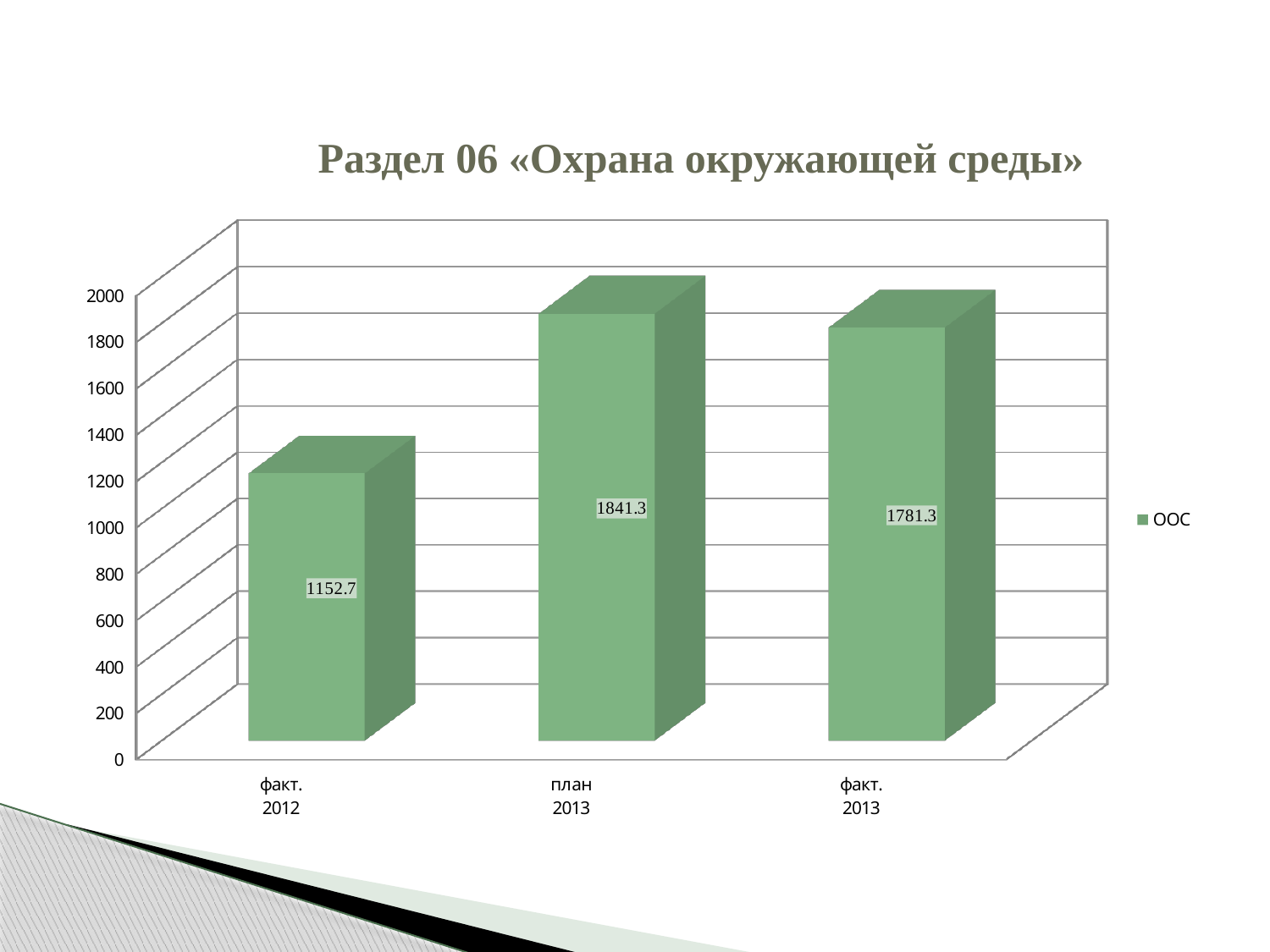
What is the difference between план 2013 and факт. 2013? 60 What is the value for факт. 2013? 1781.3 How many categories are shown on the chart? 3 What is the value for план 2013? 1841.3 What is the title of the chart? Раздел 06 «Охрана окружающей среды» What is the difference between факт. 2013 and факт. 2012? 628.6 Which category has the lowest value? факт. 2012 What kind of chart is shown on the slide? bar chart How many series does the legend list? 1 What is the value for факт. 2012? 1152.7 Which category has the highest value? план 2013 Which is larger, the value for факт. 2012 or the value for факт. 2013? факт. 2013